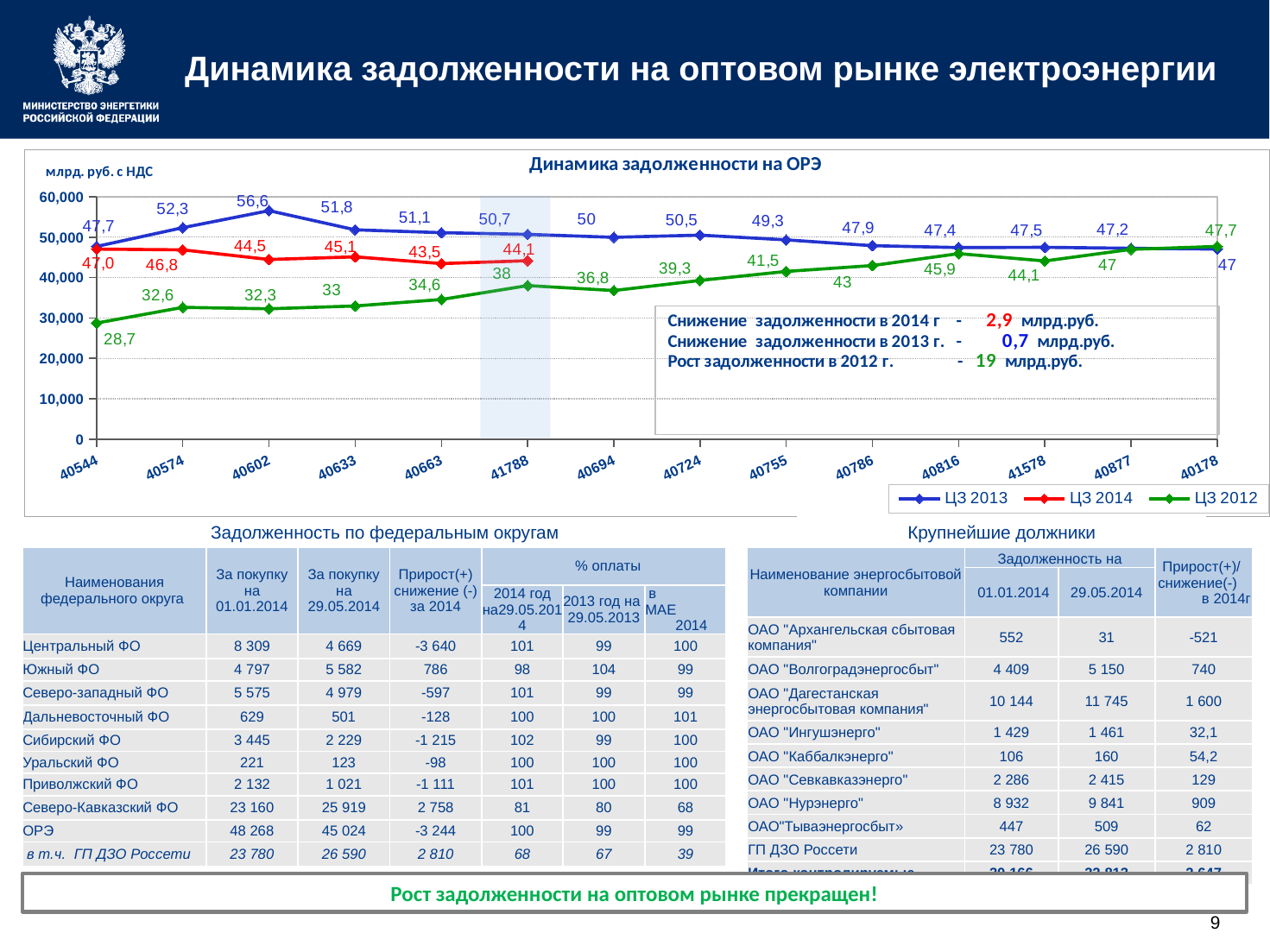
What is the value of the ЦЗ 2014 series at the first x-axis category, 40544? 47,0 At the x-axis category 40544, which series has the larger value, ЦЗ 2013 or ЦЗ 2012? ЦЗ 2013 What is the lowest value of the ЦЗ 2012 series? 28,7 What is the difference between the ЦЗ 2013 value and the ЦЗ 2012 value at the x-axis category 40602? 24,3 What is the value of the ЦЗ 2013 series at the x-axis category 40602? 56,6 What kind of chart is shown on the slide? line chart What unit is shown for the y axis of the chart? млрд. руб. с НДС At which x-axis category does the ЦЗ 2013 series reach its highest value? 40602 How many series does the chart legend list? 3 How many categories are shown along the x axis of the chart? 14 What is the lowest value of the ЦЗ 2014 series? 43,5 Does the ЦЗ 2012 series generally rise or fall along the x axis? rise